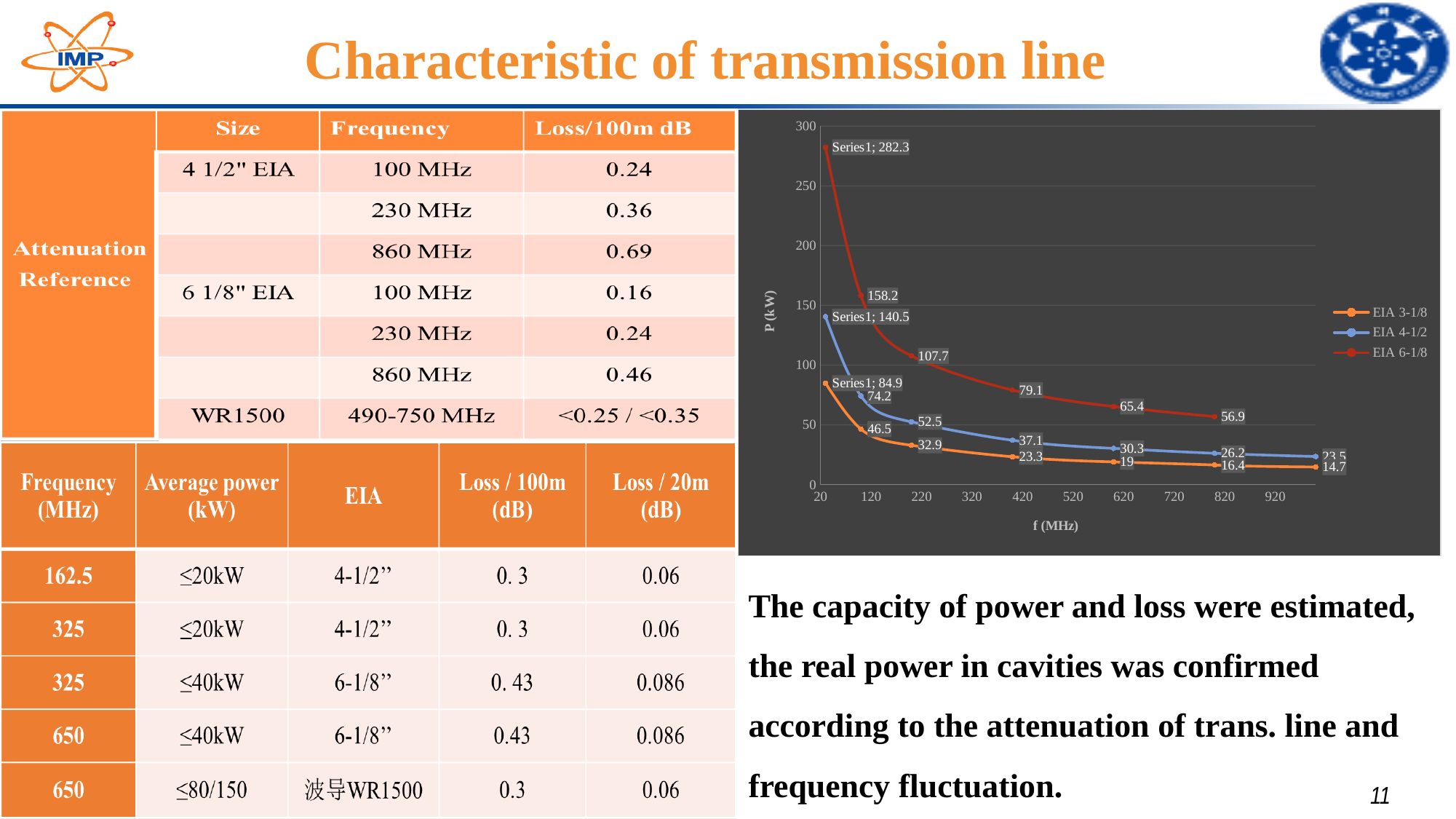
What is the label of the y axis of the chart? P (kW) Which series has the highest power values across the chart? EIA 6-1/8 How many series does the legend of the chart list? 3 What type of chart is shown on the right side of the slide? line chart What are the three series named in the chart legend? EIA 3-1/8, EIA 4-1/2, EIA 6-1/8 What is the last (rightmost) value plotted for the EIA 6-1/8 series? 56.9 What is the highest value plotted for the EIA 4-1/2 series? 140.5 Do the plotted power values rise or fall as frequency increases along the x axis? fall Which series has the lowest power values across the chart? EIA 3-1/8 What is the last (rightmost) value plotted for the EIA 3-1/8 series? 14.7 What is the highest value plotted for the EIA 3-1/8 series? 84.9 What is the highest value plotted for the EIA 6-1/8 series? 282.3